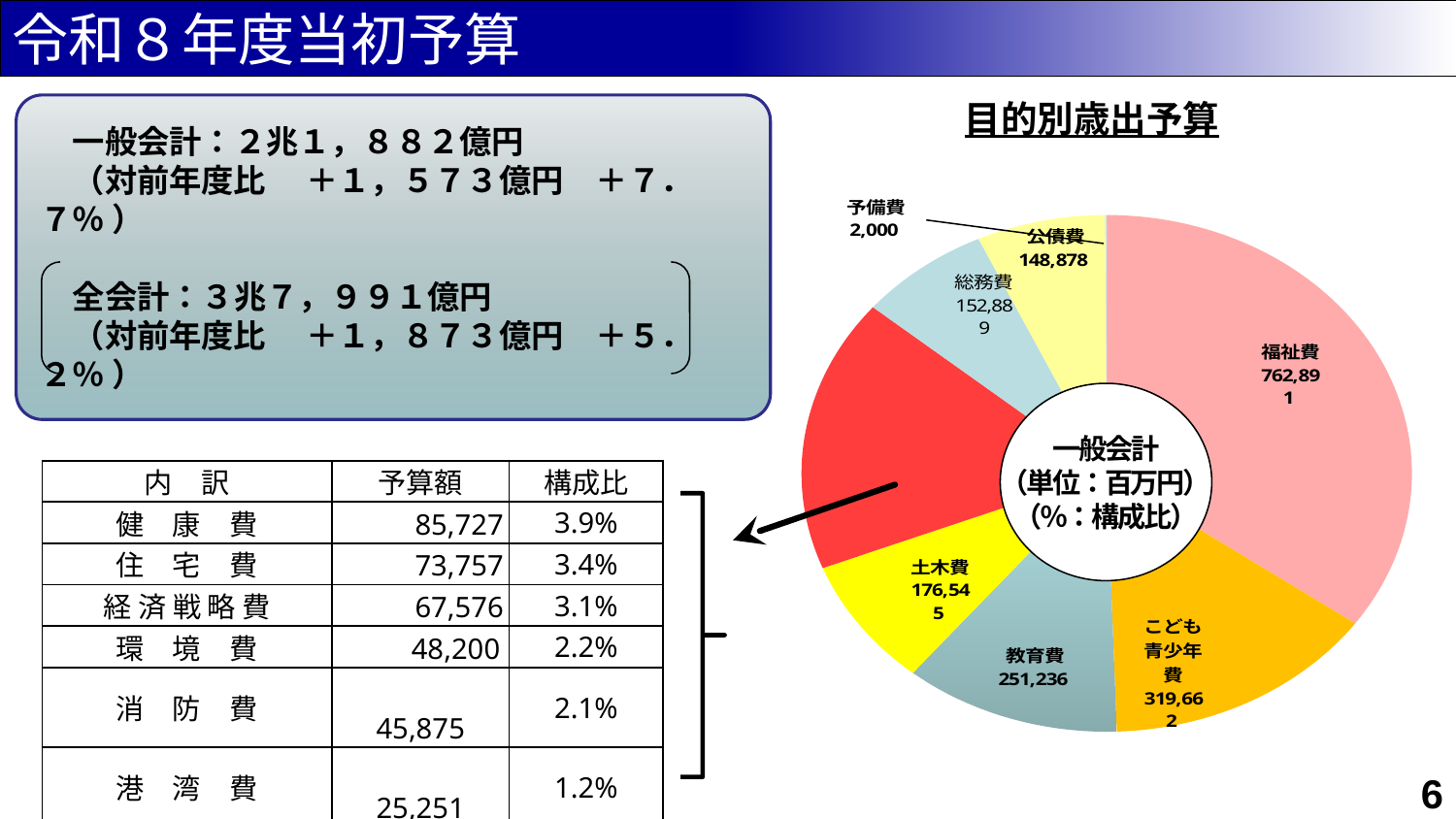
Which has the larger value in the pie chart, 総務費 or 公債費? 総務費 What is the value shown for 土木費 in the pie chart? 176,545 What is the difference between the values for 福祉費 and こども青少年費 in the pie chart? 443,229 What is the value shown for 教育費 in the pie chart? 251,236 What is the value shown for こども青少年費 in the pie chart? 319,662 What is the difference between the values for 教育費 and 土木費 in the pie chart? 74,691 Which labeled category has the smallest slice in the pie chart? 予備費 What kind of chart is shown on the slide? Pie chart What is the value shown for 福祉費 in the pie chart? 762,891 What is the value shown for 予備費 in the pie chart? 2,000 Which labeled category has the largest slice in the pie chart? 福祉費 What is the title of the chart on the slide? 目的別歳出予算